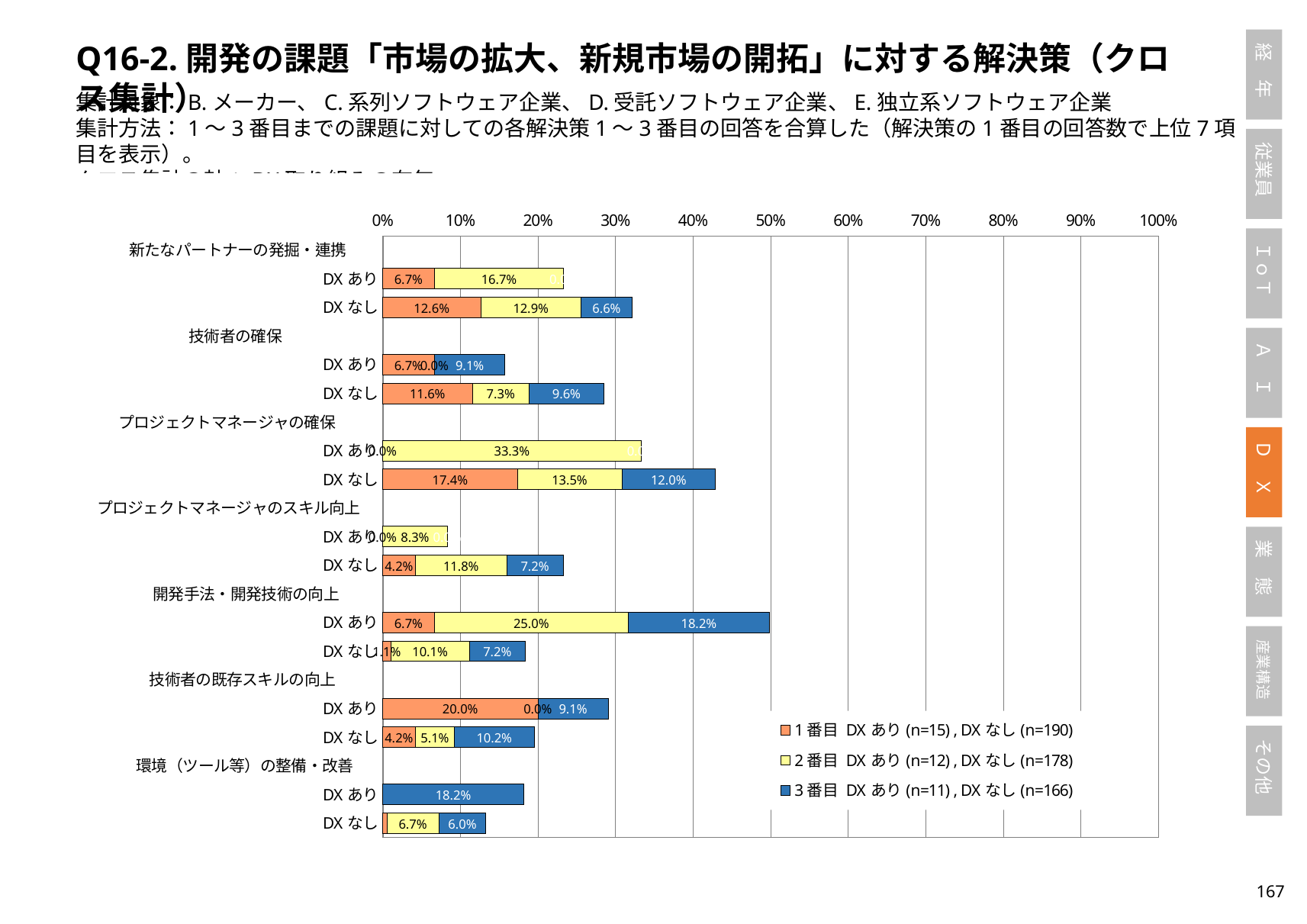
Which has the larger 1番目 value: DX なし under プロジェクトマネージャの確保 or DX なし under 新たなパートナーの発掘・連携? DX なし under プロジェクトマネージャの確保 Is the total of the stacked bar for DX あり under 開発手法・開発技術の向上 greater or less than 40%? greater How many series does the legend list? 3 What kind of chart is shown on the slide? Stacked horizontal bar chart What is the total of the stacked bar for DX なし under プロジェクトマネージャの確保? 42.9% What is the 1番目 value for DX あり under 技術者の既存スキルの向上? 20.0% What is the total of the stacked bar for DX あり under 開発手法・開発技術の向上? 49.9% What is the 2番目 value for DX あり under プロジェクトマネージャの確保? 33.3% Which bar has the highest 1番目 value in the chart? DX あり under 技術者の既存スキルの向上 What is the difference between the 2番目 values for DX あり and DX なし under 開発手法・開発技術の向上? 14.9 percentage points What is the 1番目 value for DX なし under プロジェクトマネージャの確保? 17.4% What is the 3番目 value for DX あり under 開発手法・開発技術の向上? 18.2%